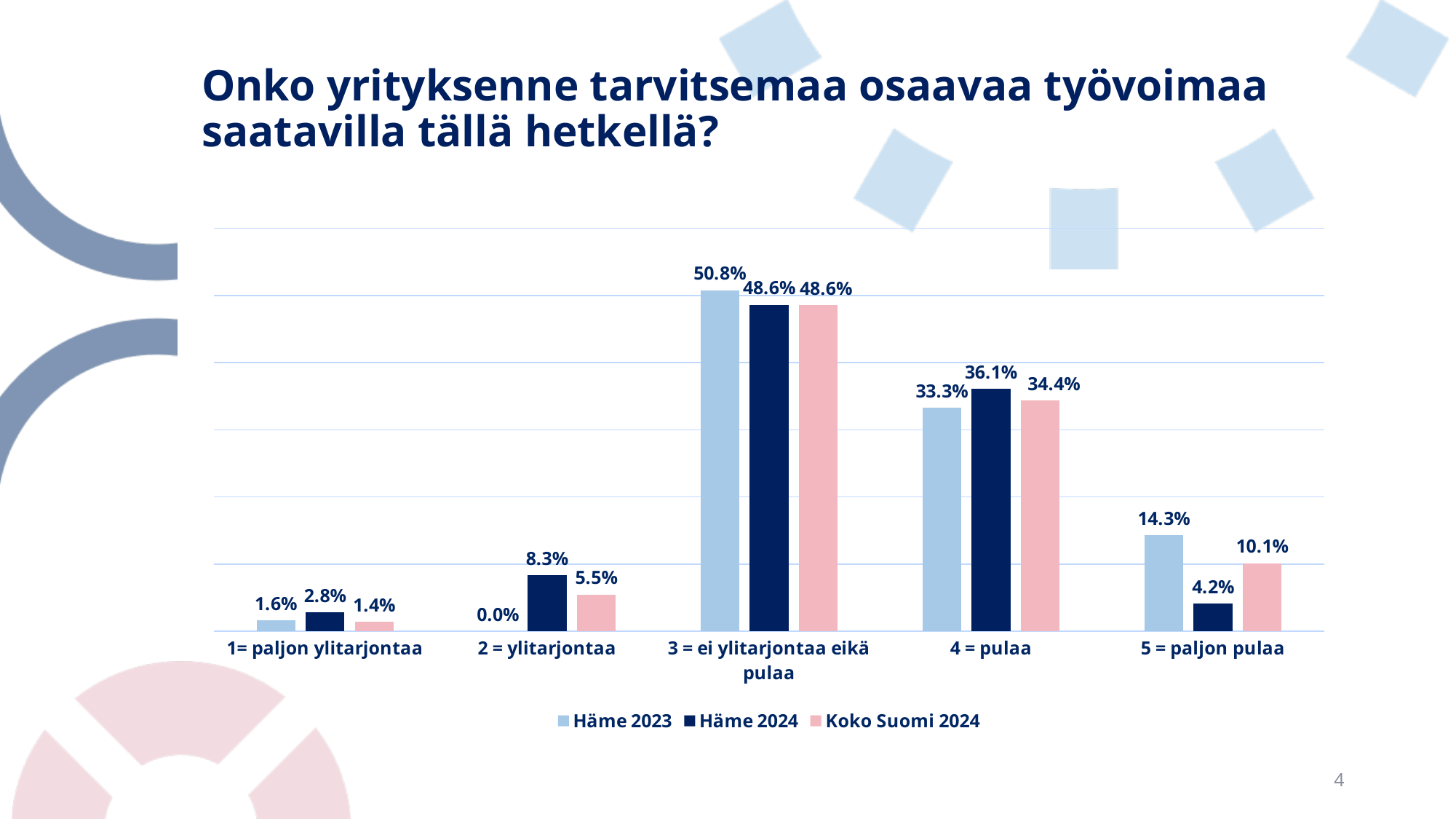
What is the value for Häme 2023 in the category '3 = ei ylitarjontaa eikä pulaa'? 50.8% What is the value for Koko Suomi 2024 in the category '5 = paljon pulaa'? 10.1% What kind of chart is shown on the slide? Bar chart What is the value for Häme 2024 in the category '2 = ylitarjontaa'? 8.3% What is the difference between Häme 2023 and Häme 2024 in the category '3 = ei ylitarjontaa eikä pulaa'? 2.2% Which is larger in the category '4 = pulaa': Häme 2024 or Koko Suomi 2024? Häme 2024 Which category has the lowest value for Häme 2023? 2 = ylitarjontaa Which category has the highest value for Häme 2024? 3 = ei ylitarjontaa eikä pulaa How many categories are shown on the x axis? 5 What is the difference between Häme 2023 and Häme 2024 in the category '5 = paljon pulaa'? 10.1% Which series is shown in pink in the legend? Koko Suomi 2024 How many series does the legend list? 3